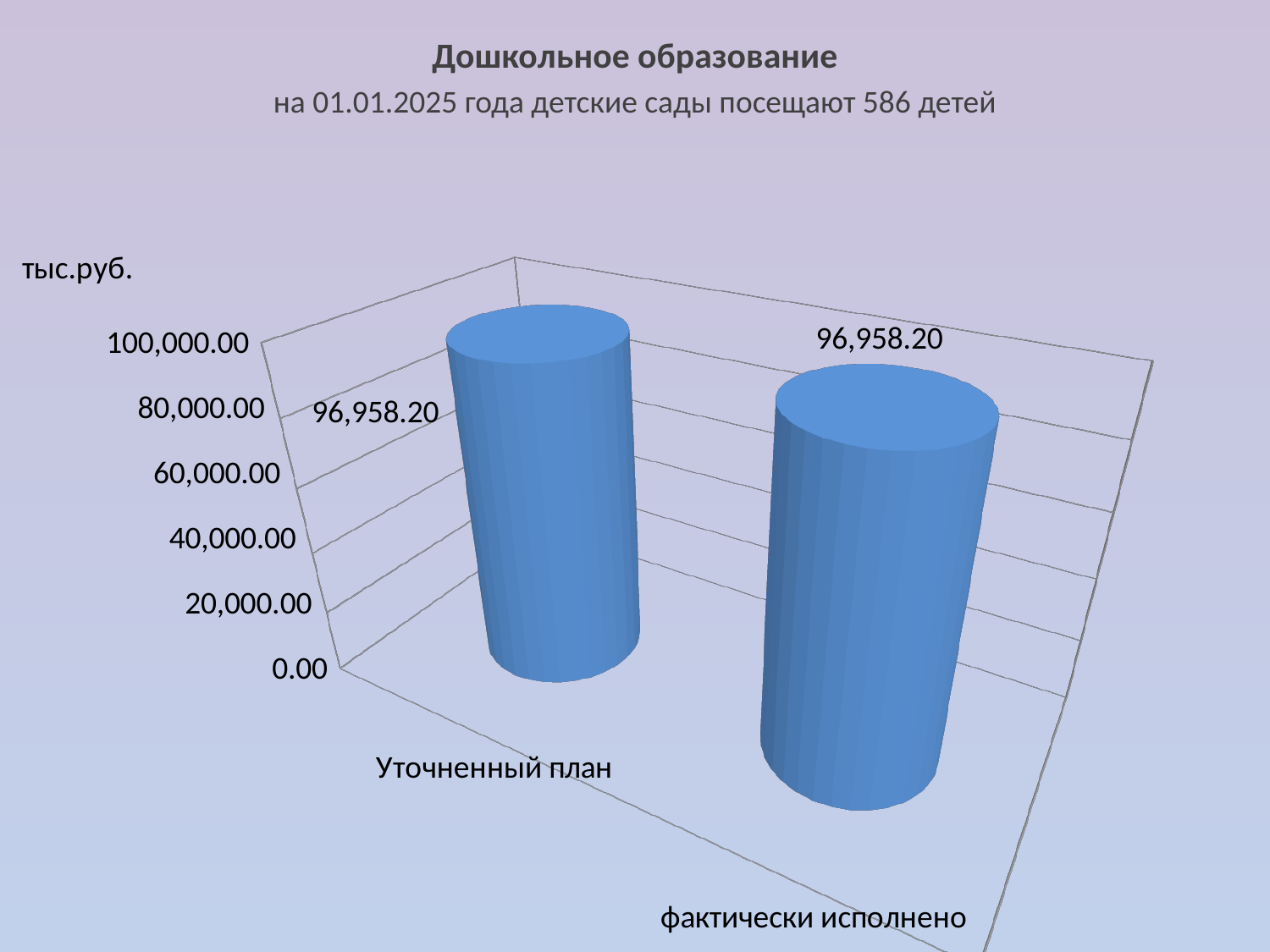
What is the difference between the values for Уточненный план and фактически исполнено? 0.00 Is the value for Уточненный план greater or less than 80,000.00? greater What is the title of the chart? тыс.руб. What kind of chart is shown on the slide? bar chart What is the value for фактически исполнено? 96,958.20 How many categories are plotted on the chart? 2 Is the value for фактически исполнено greater or less than 100,000.00? less What unit is shown on the vertical axis of the chart? тыс.руб. What is the value for Уточненный план? 96,958.20 Do the values rise, fall or stay the same from Уточненный план to фактически исполнено? stay the same